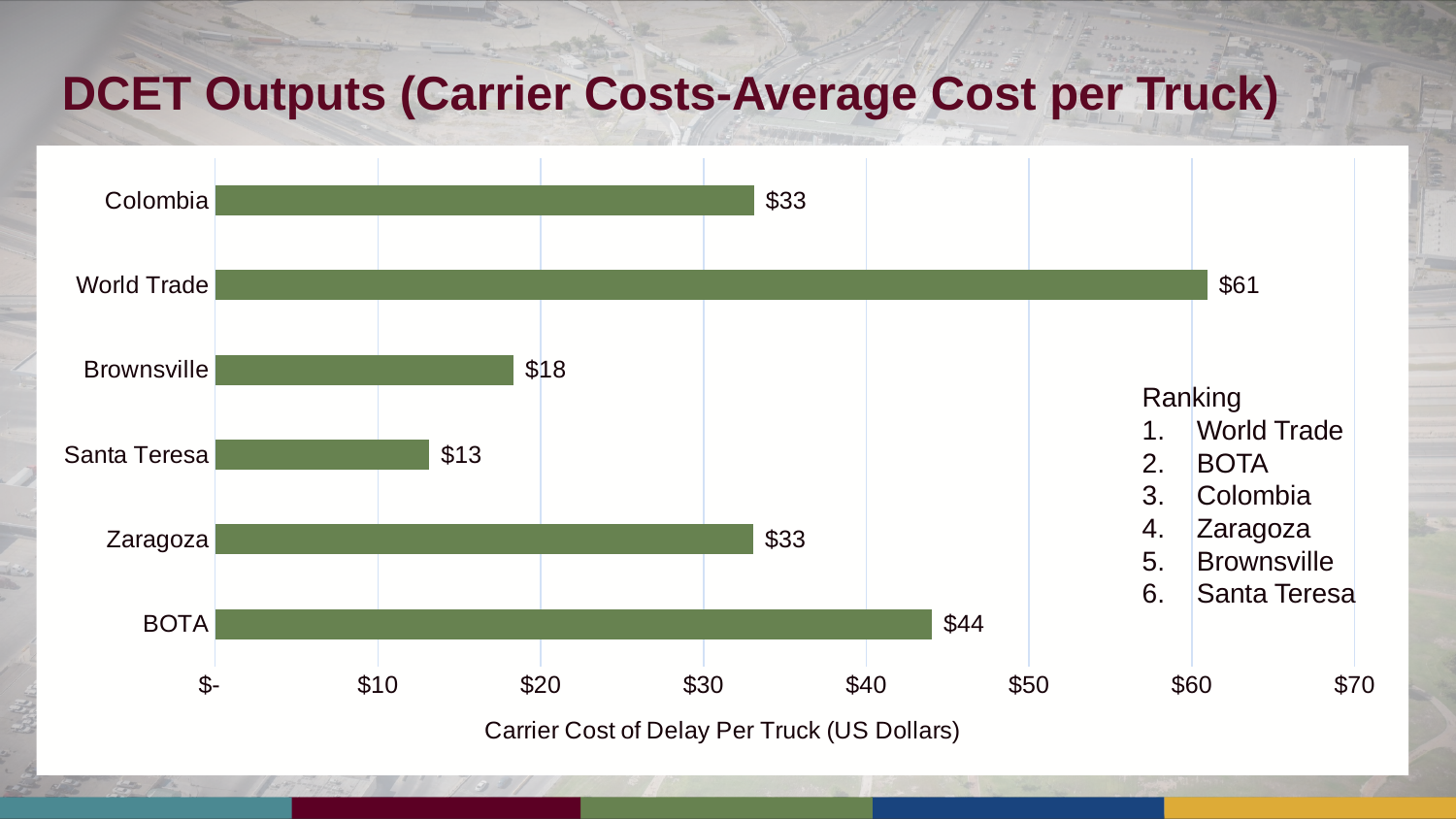
Which crossing has the highest carrier cost of delay per truck? World Trade What is the carrier cost of delay per truck for BOTA? $44 What is the label of the horizontal axis of the chart? Carrier Cost of Delay Per Truck (US Dollars) What is the carrier cost of delay per truck for Santa Teresa? $13 Which has a larger carrier cost of delay per truck, BOTA or Zaragoza? BOTA What is the carrier cost of delay per truck for World Trade? $61 What is the difference between the carrier cost per truck for Brownsville and Santa Teresa? $5 Which crossing has the lowest carrier cost of delay per truck? Santa Teresa How many crossings are shown in the chart? 6 What kind of chart is shown on the slide? Bar chart Is the value for Brownsville greater or less than $20? less What is the difference between the carrier cost per truck for World Trade and BOTA? $17